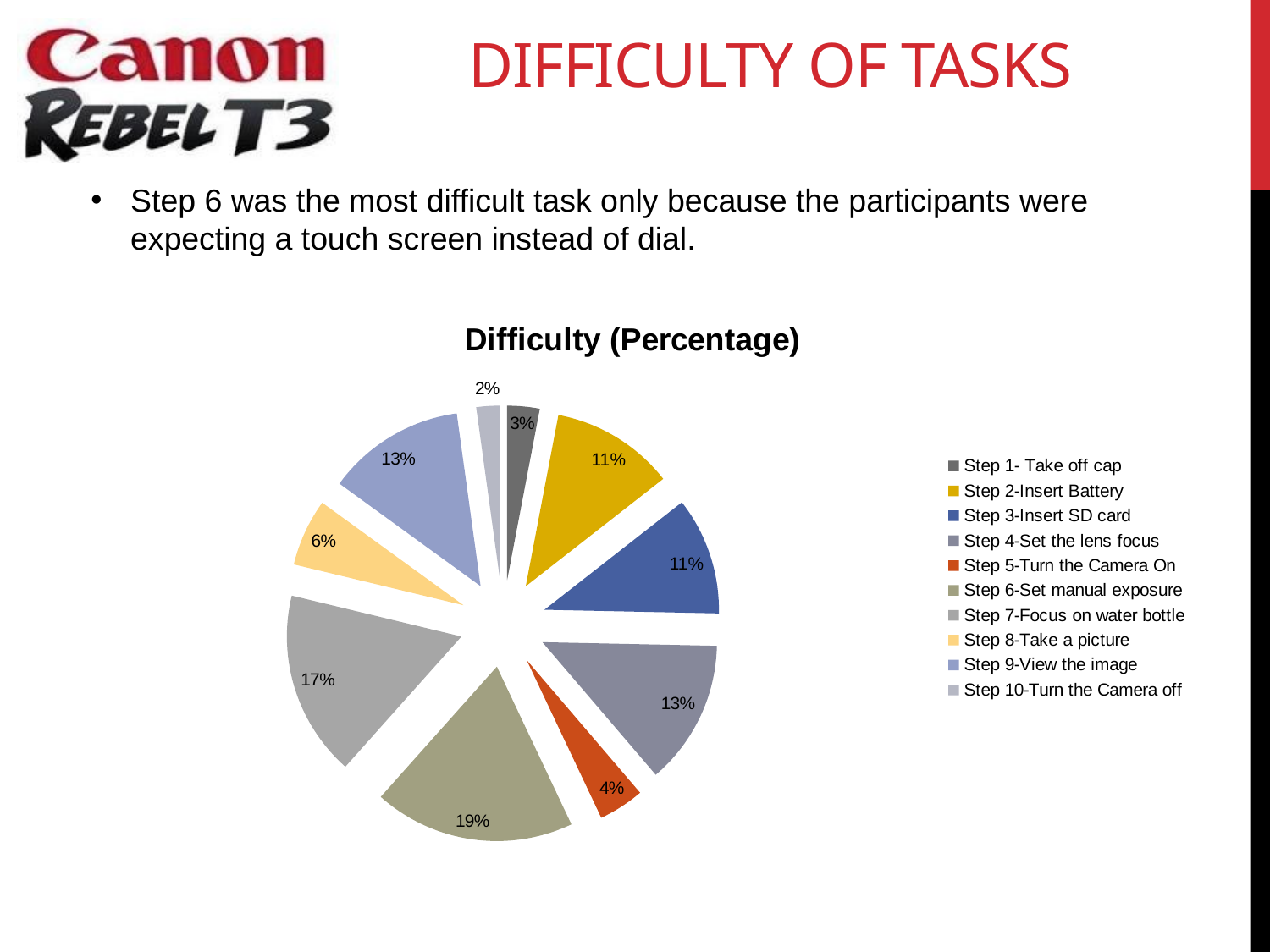
Which step has the largest share of the pie? Step 6-Set manual exposure What type of chart is shown on the slide? pie chart How many slices does the pie chart have? 10 Which has a larger share, Step 1- Take off cap or Step 2-Insert Battery? Step 2-Insert Battery Which step has the smallest share of the pie? Step 10-Turn the Camera off What is the difference in percentage points between Step 6-Set manual exposure and Step 7-Focus on water bottle? 2 What percentage is shown for Step 8-Take a picture? 6% What percentage is shown for Step 6-Set manual exposure? 19% What percentage is shown for Step 5-Turn the Camera On? 4% What percentage is shown for Step 7-Focus on water bottle? 17% What is the title of the chart? Difficulty (Percentage) How many entries are listed in the legend? 10